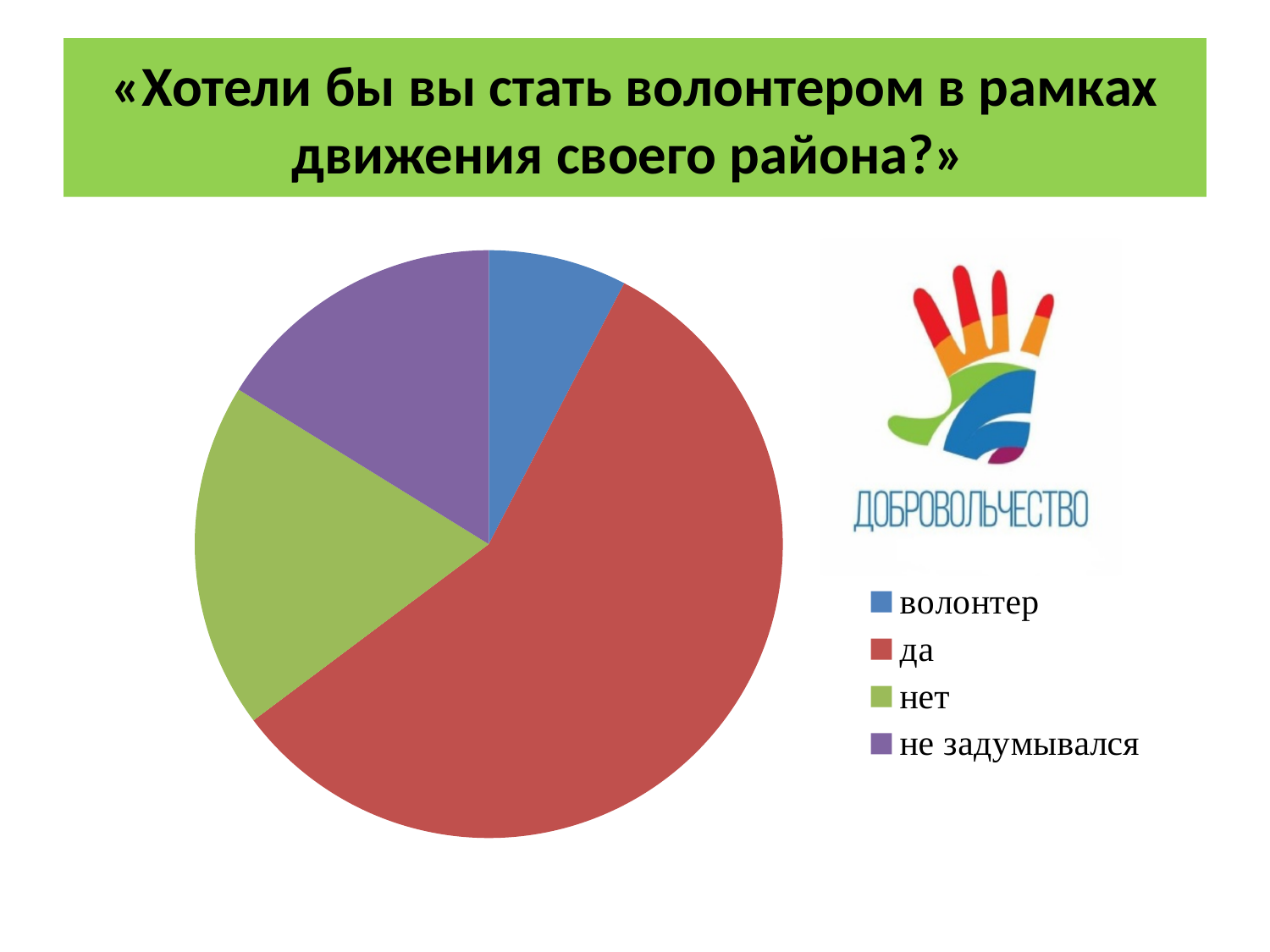
What kind of chart is shown on the slide? pie chart Which slice is larger, не задумывался or волонтер? не задумывался Which category has the smallest slice of the pie chart? волонтер Which slice is larger, да or нет? да Which category is shown in green in the pie chart? нет Does the да slice take up more or less than half of the pie? more How many entries does the legend of the pie chart list? 4 How many slices does the pie chart have? 4 Which category has the largest slice of the pie chart? да Which slice is larger, нет or волонтер? нет What colour is the slice for не задумывался? purple